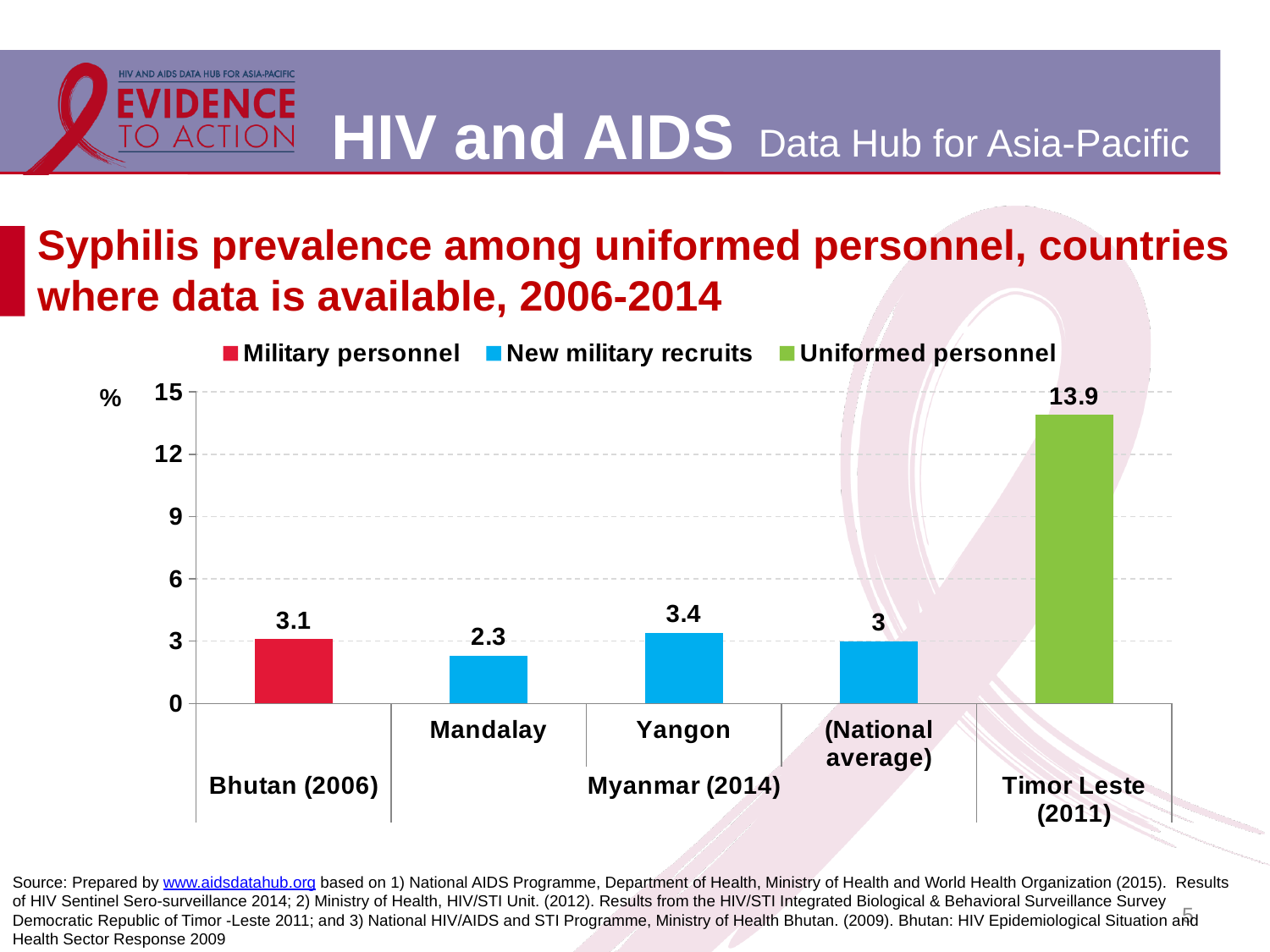
Which bar has the lowest value? Mandalay Which bar has the highest value? Timor Leste (2011) What is the syphilis prevalence for Bhutan (2006)? 3.1 What is the syphilis prevalence for Mandalay in Myanmar (2014)? 2.3 How many bars are plotted in the chart? 5 What type of chart is shown? Bar chart What is the syphilis prevalence for Timor Leste (2011)? 13.9 What is the difference between the values for Timor Leste (2011) and Bhutan (2006)? 10.8 Which is larger, the value for Yangon or the value for Mandalay? Yangon What is the syphilis prevalence for Yangon in Myanmar (2014)? 3.4 How many series does the legend list? 3 What is the national average syphilis prevalence for Myanmar (2014)? 3